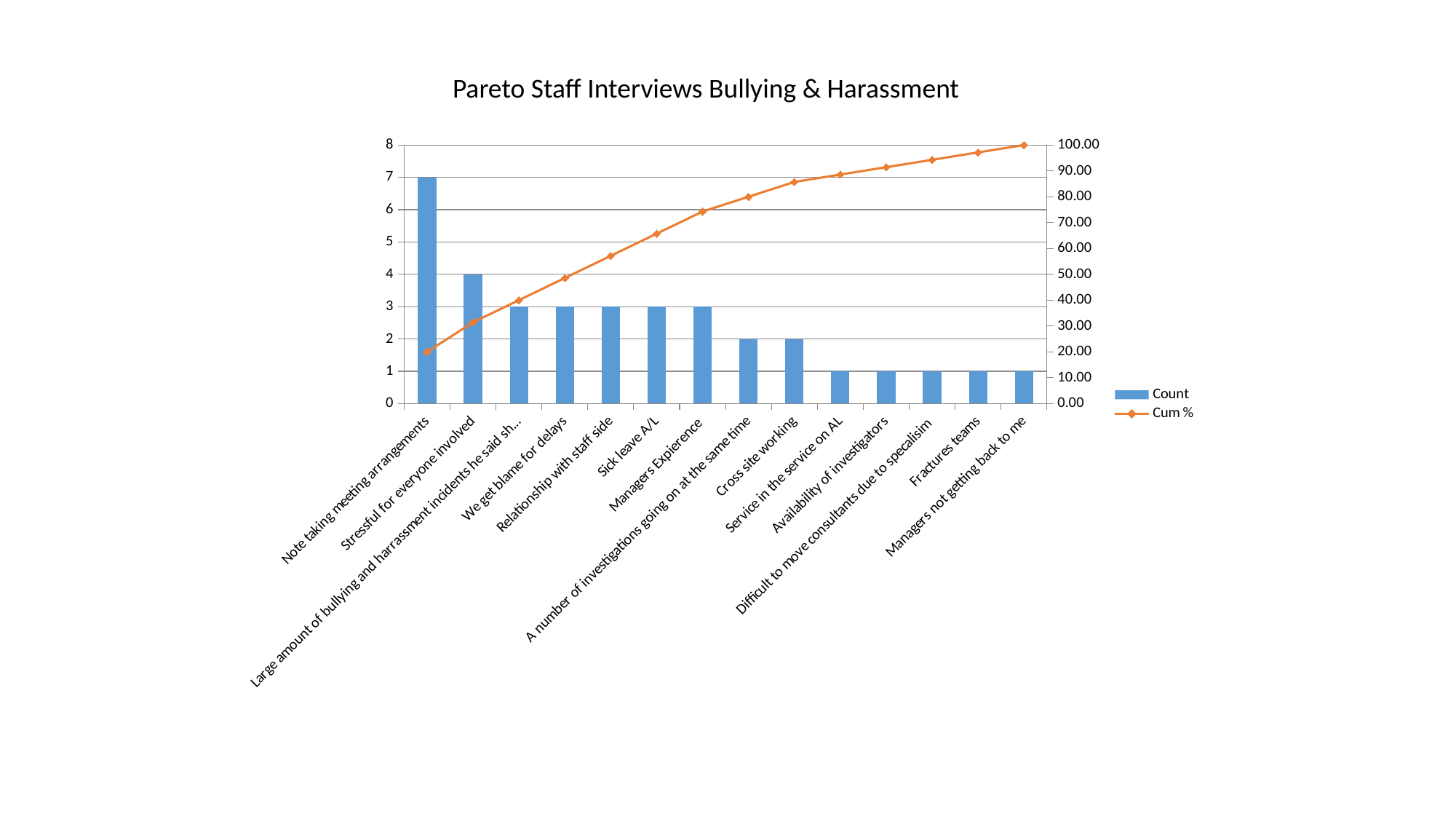
What is the Count for Cross site working? 2 Is the Cum % value for Note taking meeting arrangements greater or less than 30.00? less Is the Cum % value for Sick leave A/L greater or less than 60.00? greater How many categories are shown on the x axis? 14 What is the Cum % value for Managers not getting back to me? 100.00 Which has a larger Count, Sick leave A/L or Fractures teams? Sick leave A/L What is the Count for Note taking meeting arrangements? 7 How many series does the legend list? 2 What is the Count for Stressful for everyone involved? 4 Which category has the highest Count? Note taking meeting arrangements Does the Cum % line rise or fall from left to right along the x axis? rises What is the difference in Count between Note taking meeting arrangements and Stressful for everyone involved? 3